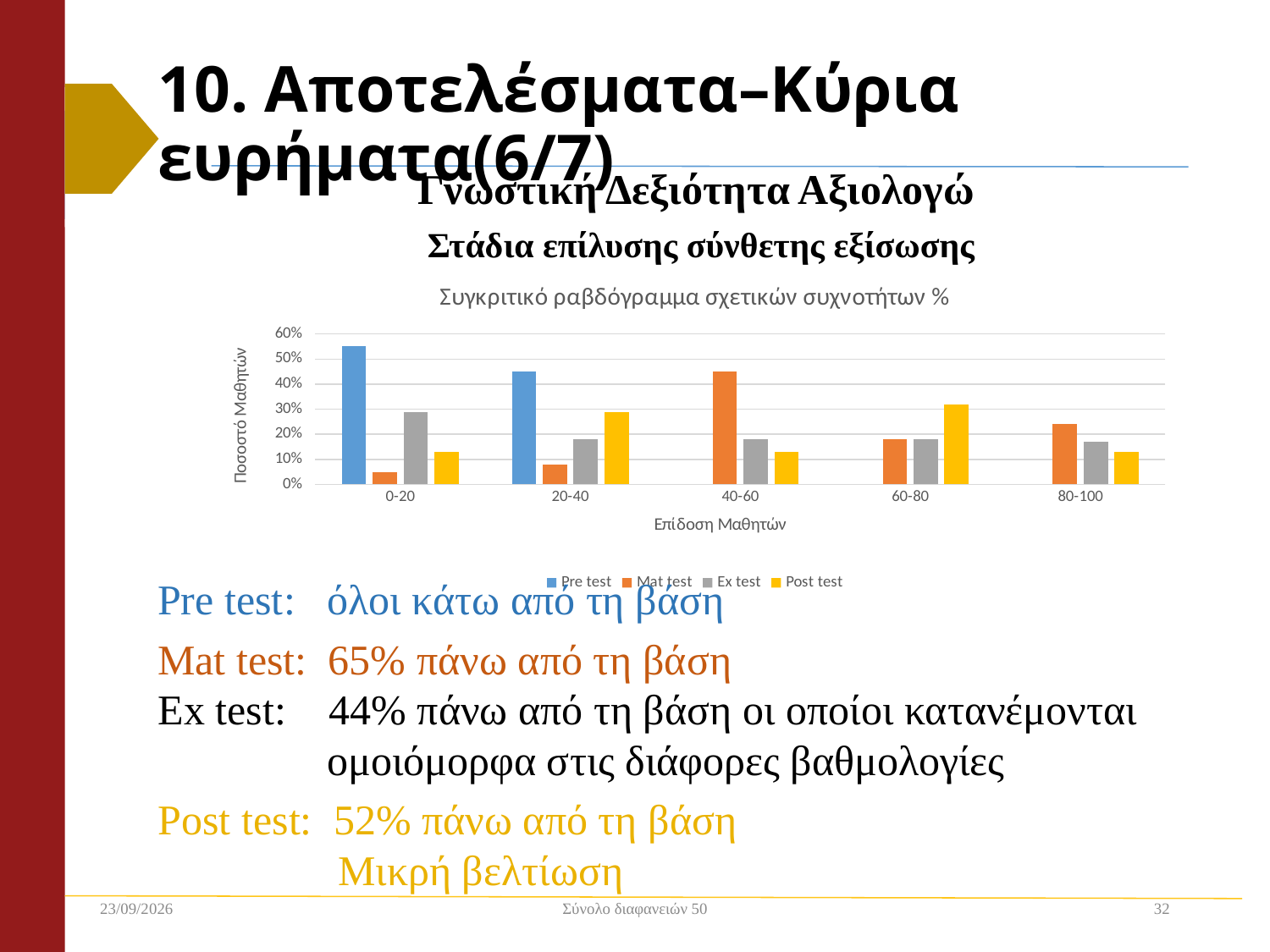
Which score category has the highest Post test value? 60-80 In the 0-20 category, which is larger: the Pre test value or the Mat test value? Pre test Is the Mat test value for the 40-60 category greater or less than 40%? greater Is the Ex test value for the 0-20 category greater or less than 20%? greater Which score category has the highest Pre test value? 0-20 How many series does the chart legend list? 4 In the 20-40 category, which is larger: the Post test value or the Ex test value? Post test What is the title of the x axis of the chart? Επίδοση Μαθητών Is the Pre test value for the 0-20 category greater or less than 50%? greater How many score categories are shown on the x axis of the chart? 5 What kind of chart is shown on the slide? bar chart Which score category has the highest Mat test value? 40-60